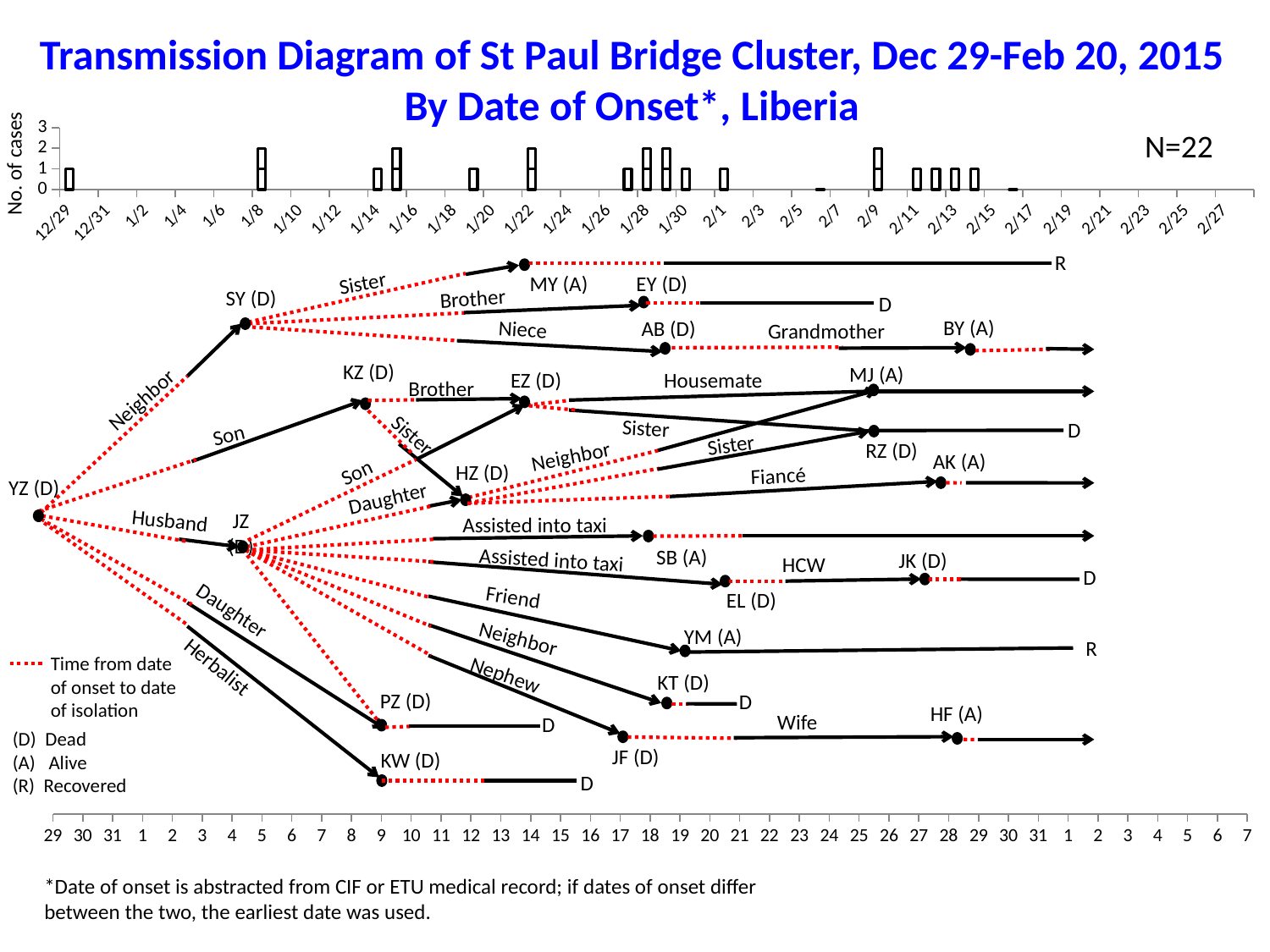
How many cases are shown for 1/22 in the bar chart? 2 What kind of chart is shown at the top of the slide above the transmission diagram? bar chart What is the label of the y-axis of the bar chart? No. of cases Is the number of cases for 12/29 greater or less than 2? less What is the maximum value shown on the y-axis of the bar chart? 3 How many cases are shown for 2/9 in the bar chart? 2 How many cases are shown for 1/8 in the bar chart? 2 Is the number of cases for 1/8 greater or less than 1? greater What is the total number of cases (N) shown on the slide? N=22 How many cases are shown for 12/29 in the bar chart? 1 What is the highest number of cases recorded on any single day in the bar chart? 2